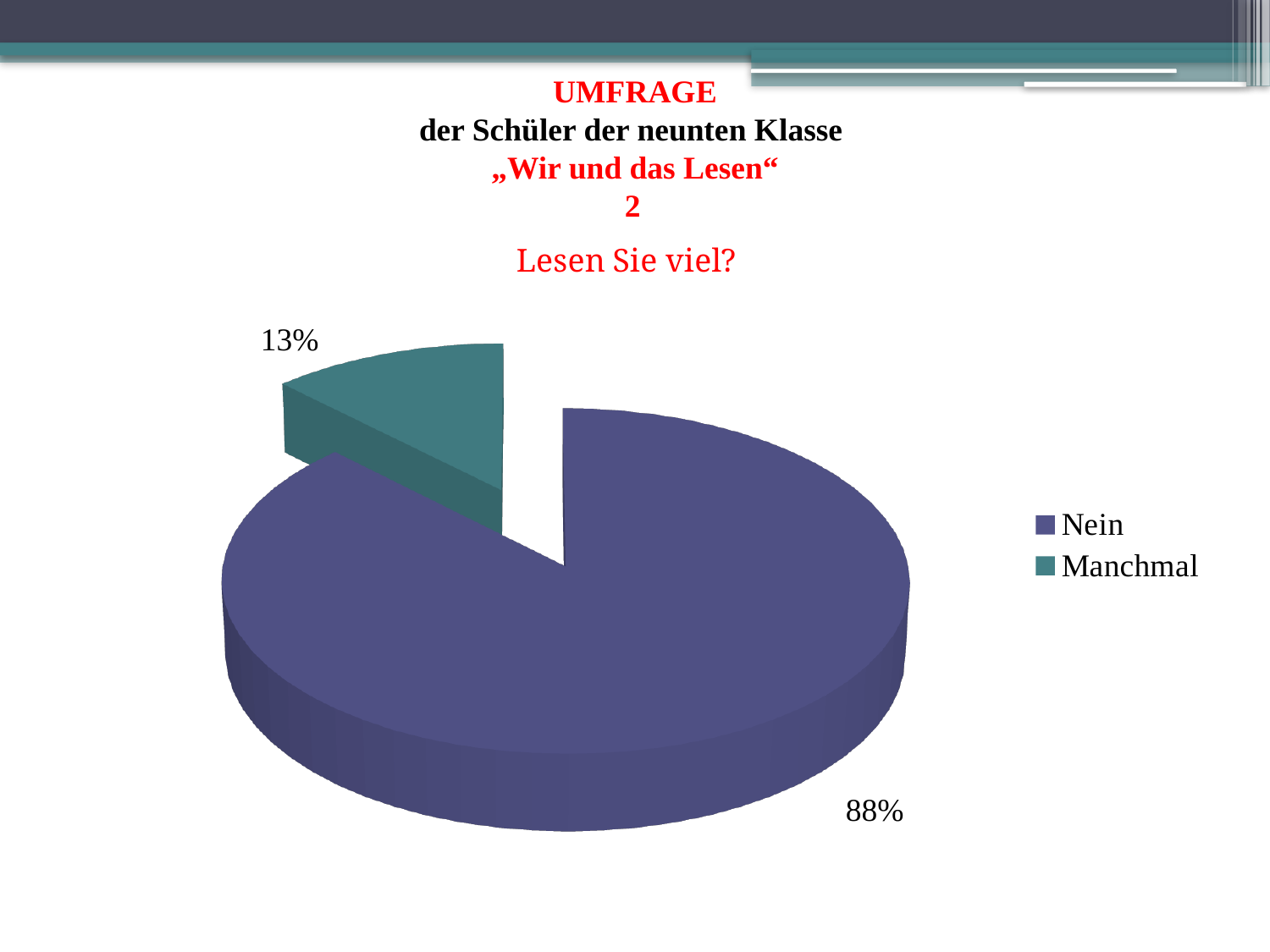
What is the difference in percentage points between the "Nein" and "Manchmal" slices? 75 Which is larger, the "Nein" slice or the "Manchmal" slice? Nein What share of the pie does the "Manchmal" slice represent? 13% Which legend entry is shown in teal/green? Manchmal Which category has the smallest slice of the pie? Manchmal Which category has the largest slice of the pie? Nein What kind of chart is shown on the slide? Pie chart How many entries does the legend list? 2 What question does the chart on the slide answer? Lesen Sie viel? What share of the pie does the "Nein" slice represent? 88% How many categories are shown in the pie chart? 2